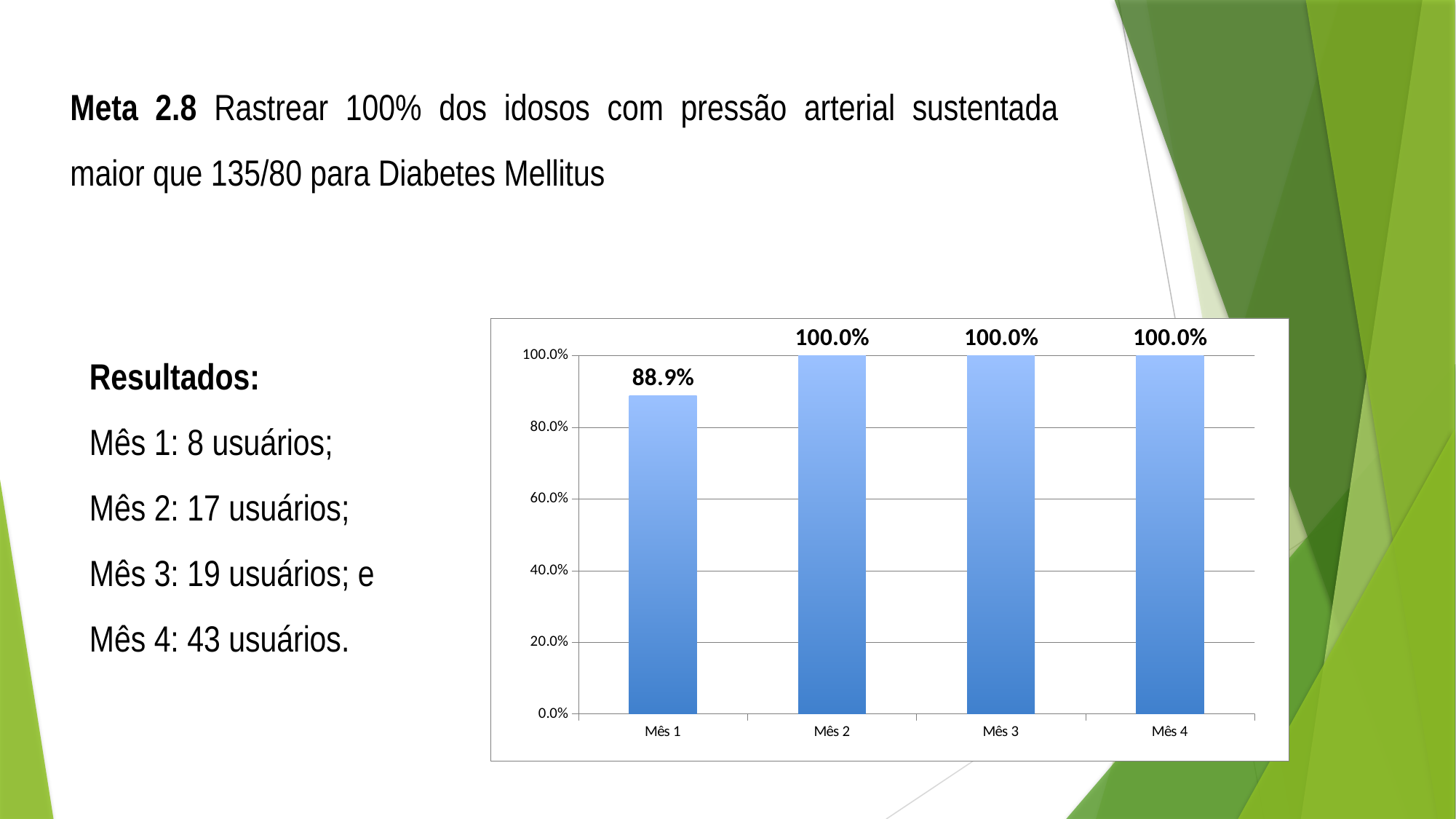
What kind of chart is shown on the slide? bar chart What is the value for Mês 2? 100.0% What is the highest value shown on the y axis? 100.0% What is the value for Mês 1? 88.9% Which month has the lowest value? Mês 1 How many months are shown on the x axis? 4 Which is larger, the value for Mês 1 or the value for Mês 3? Mês 3 What is the value for Mês 4? 100.0% Is the value for Mês 1 greater or less than 80.0%? greater Do the values rise or fall from Mês 1 to Mês 2? rise What is the difference between the values for Mês 2 and Mês 1? 11.1% How many months reach 100.0%? 3